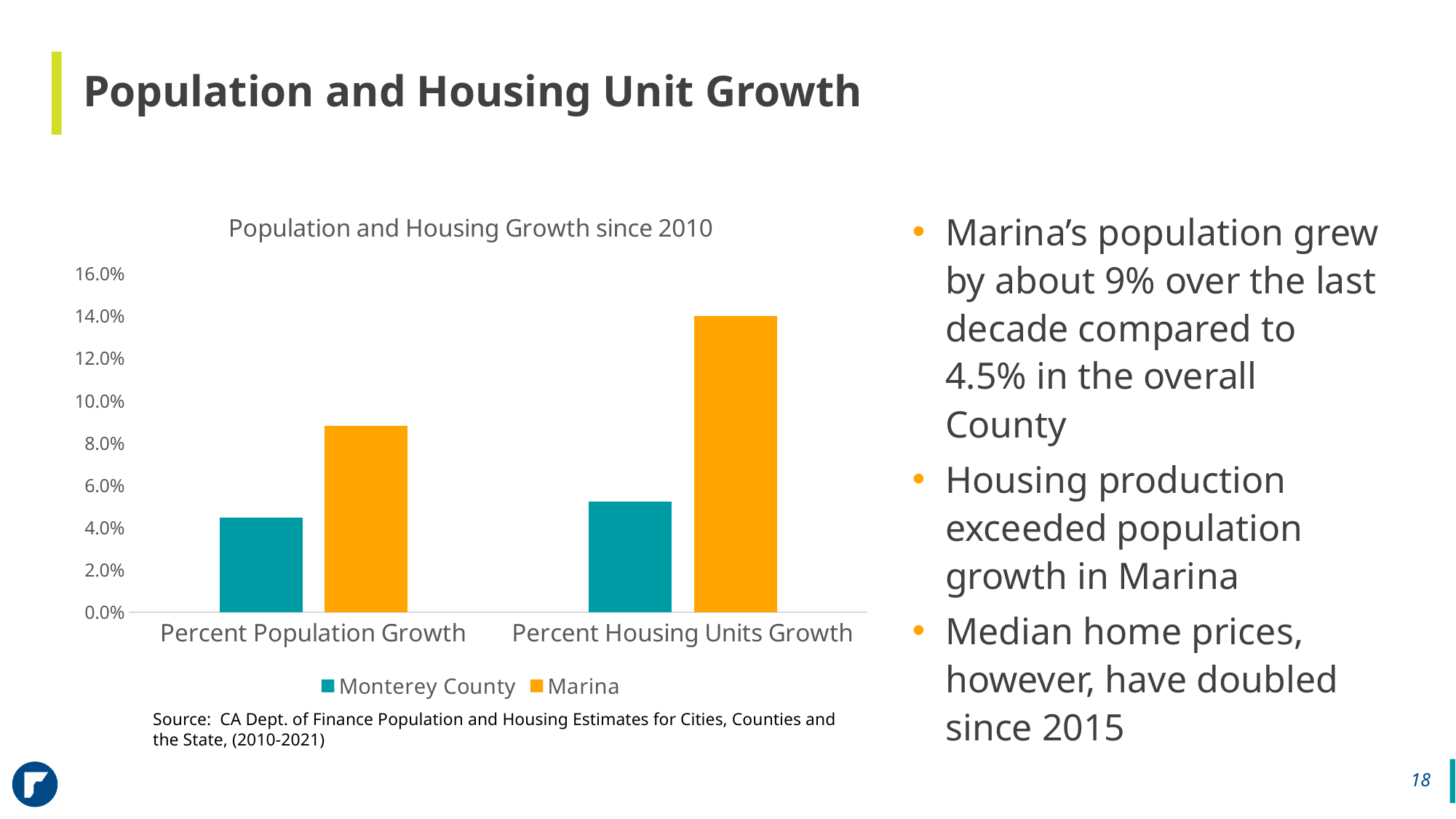
Which bar is the lowest in the chart? Monterey County, Percent Population Growth Which bar is the highest in the chart? Marina, Percent Housing Units Growth Is the value for Marina's Percent Population Growth greater or less than 8.0%? greater How many categories are shown on the x axis of the chart? 2 For Percent Housing Units Growth, which is larger: Monterey County or Marina? Marina What is the title of the chart? Population and Housing Growth since 2010 How many series does the chart legend list? 2 Is the value for Monterey County's Percent Population Growth greater or less than 6.0%? less For Percent Population Growth, which is larger: Monterey County or Marina? Marina Which series is shown in orange in the chart? Marina Is the value for Marina's Percent Housing Units Growth greater or less than 12.0%? greater What kind of chart is shown on the slide? Bar chart